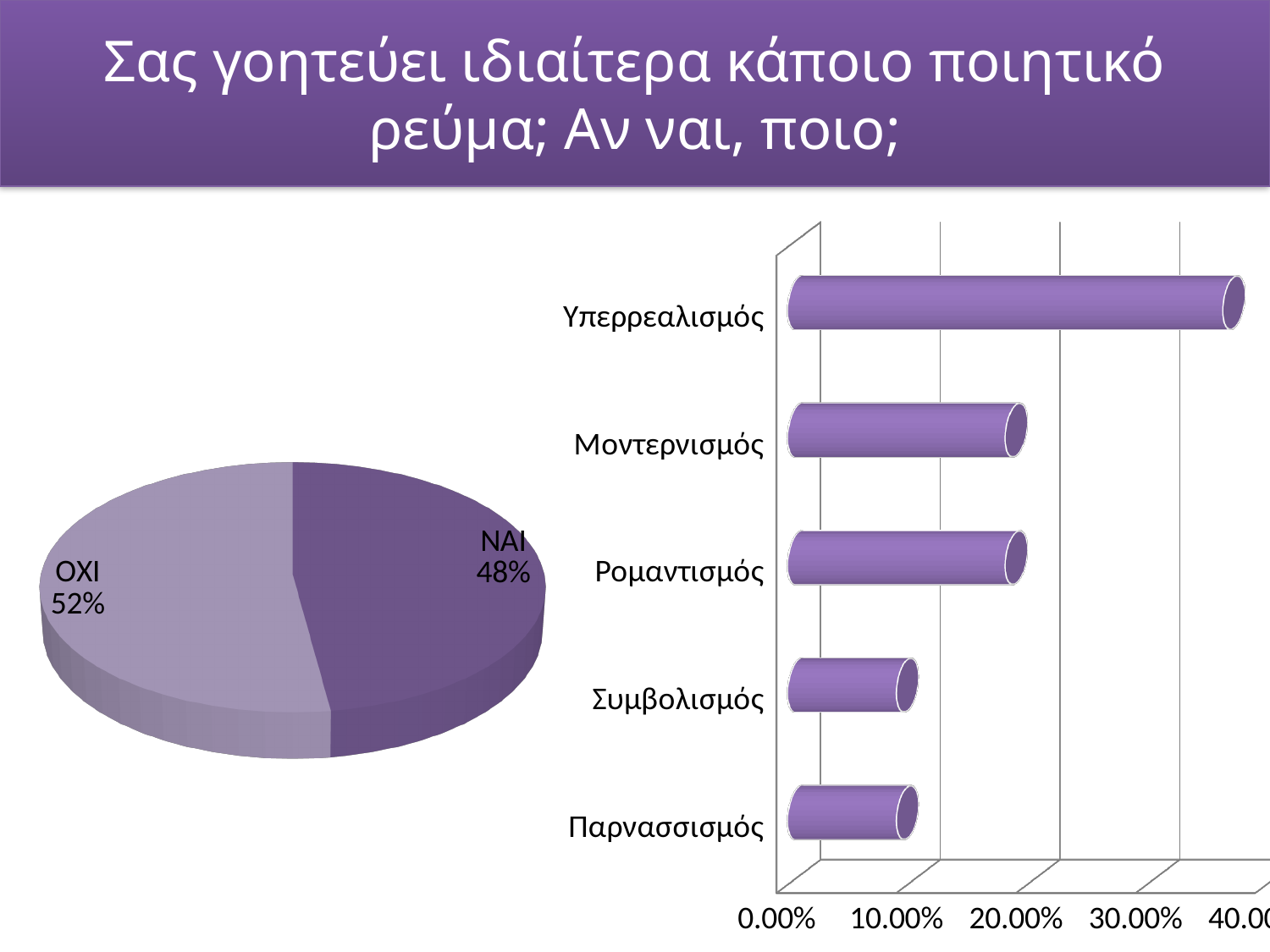
What kind of chart is the chart on the left of the slide? Pie chart In the pie chart on the left, which slice is larger, ΝΑΙ or ΟΧΙ? ΟΧΙ What kind of chart is the chart on the right of the slide? Bar chart In the bar chart on the right, is the value for Υπερρεαλισμός greater or less than 30.00%? greater In the bar chart on the right, which is larger, the value for Μοντερνισμός or the value for Παρνασσισμός? Μοντερνισμός In the pie chart on the left, what percentage is shown for ΟΧΙ? 52% In the pie chart on the left, what is the difference in percentage points between ΟΧΙ and ΝΑΙ? 4% In the pie chart on the left, what percentage is shown for ΝΑΙ? 48% How many slices does the pie chart on the left have? 2 In the bar chart on the right, which category has the highest value? Υπερρεαλισμός How many categories are shown in the bar chart on the right? 5